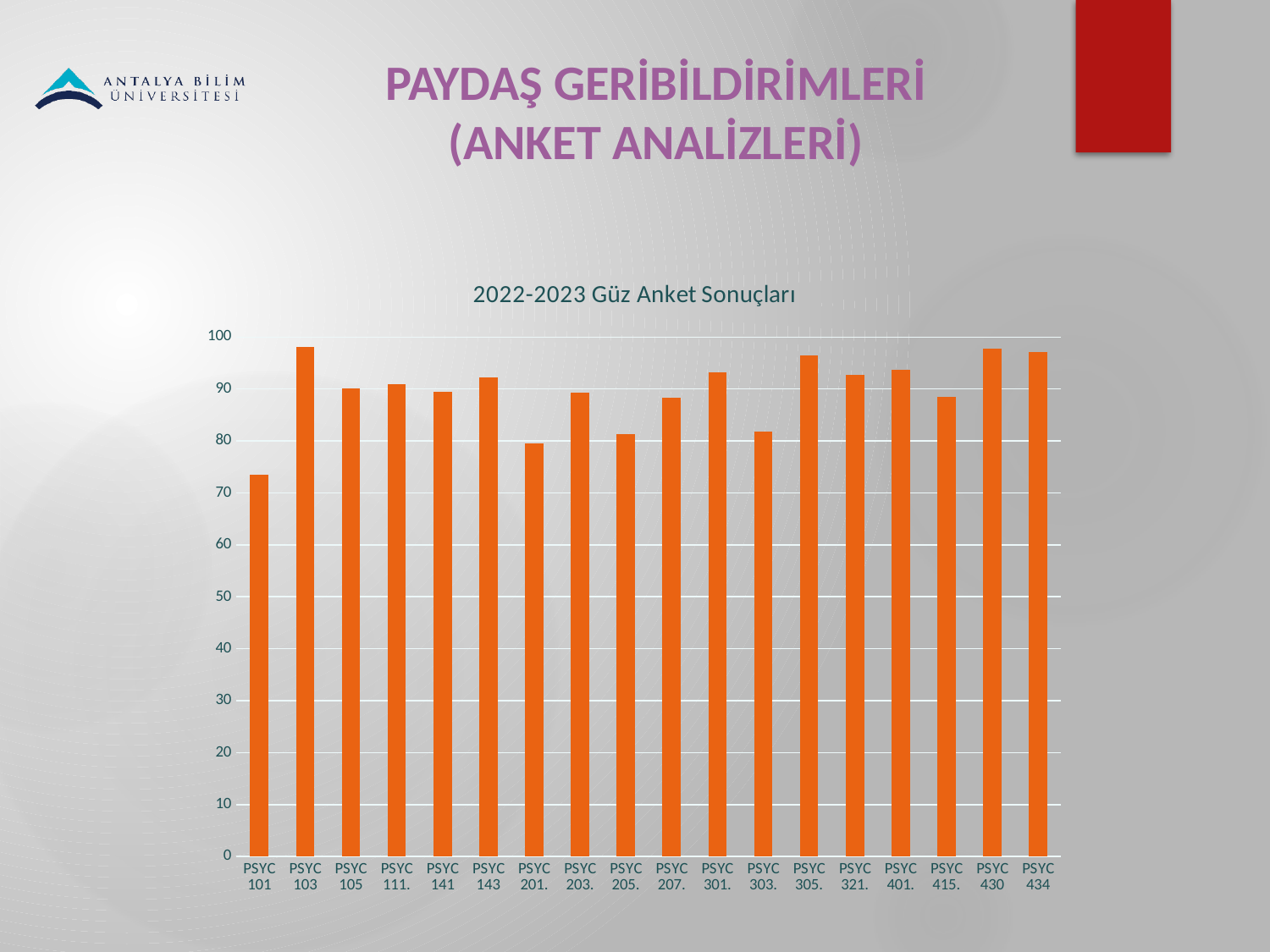
Is the value for PSYC 103 greater or less than 90? greater Is the value for PSYC 201 greater or less than 70? greater What kind of chart is shown on the slide? bar chart Which is larger, the value for PSYC 103 or the value for PSYC 101? PSYC 103 Is the value for PSYC 101 greater or less than 80? less Which is larger, the value for PSYC 305 or the value for PSYC 303? PSYC 305 Which course has the lowest value in the chart? PSYC 101 How many courses (categories) are plotted on the x axis? 18 Which is larger, the value for PSYC 143 or the value for PSYC 201? PSYC 143 What is the title of the chart? 2022-2023 Güz Anket Sonuçları